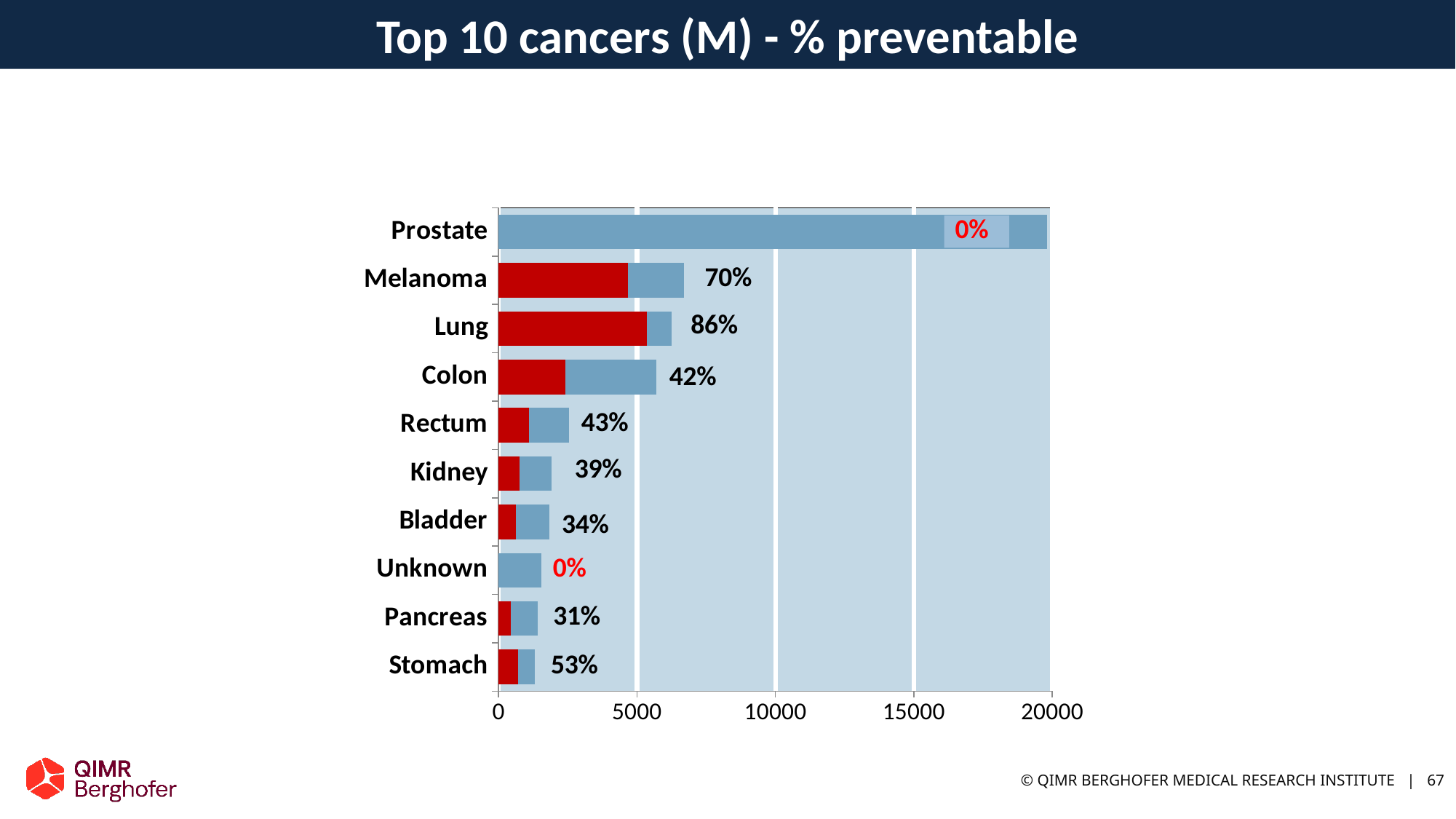
What type of chart is shown on the slide? Bar chart Which cancer has the longest bar on the chart? Prostate What is the difference in percentage points between the preventable labels for Lung and Melanoma? 16 percentage points What percentage preventable is shown for Melanoma? 70% Which has a higher percentage preventable label, Melanoma or Colon? Melanoma What percentage preventable is shown for Pancreas? 31% What percentage preventable is shown for Stomach? 53% Is the total bar length for Rectum greater or less than 5000? less Which cancer has the highest percentage preventable label? Lung Is the total bar length for Prostate greater or less than 15000? greater How many cancer categories are shown on the chart? 10 What percentage preventable is shown for Lung? 86%